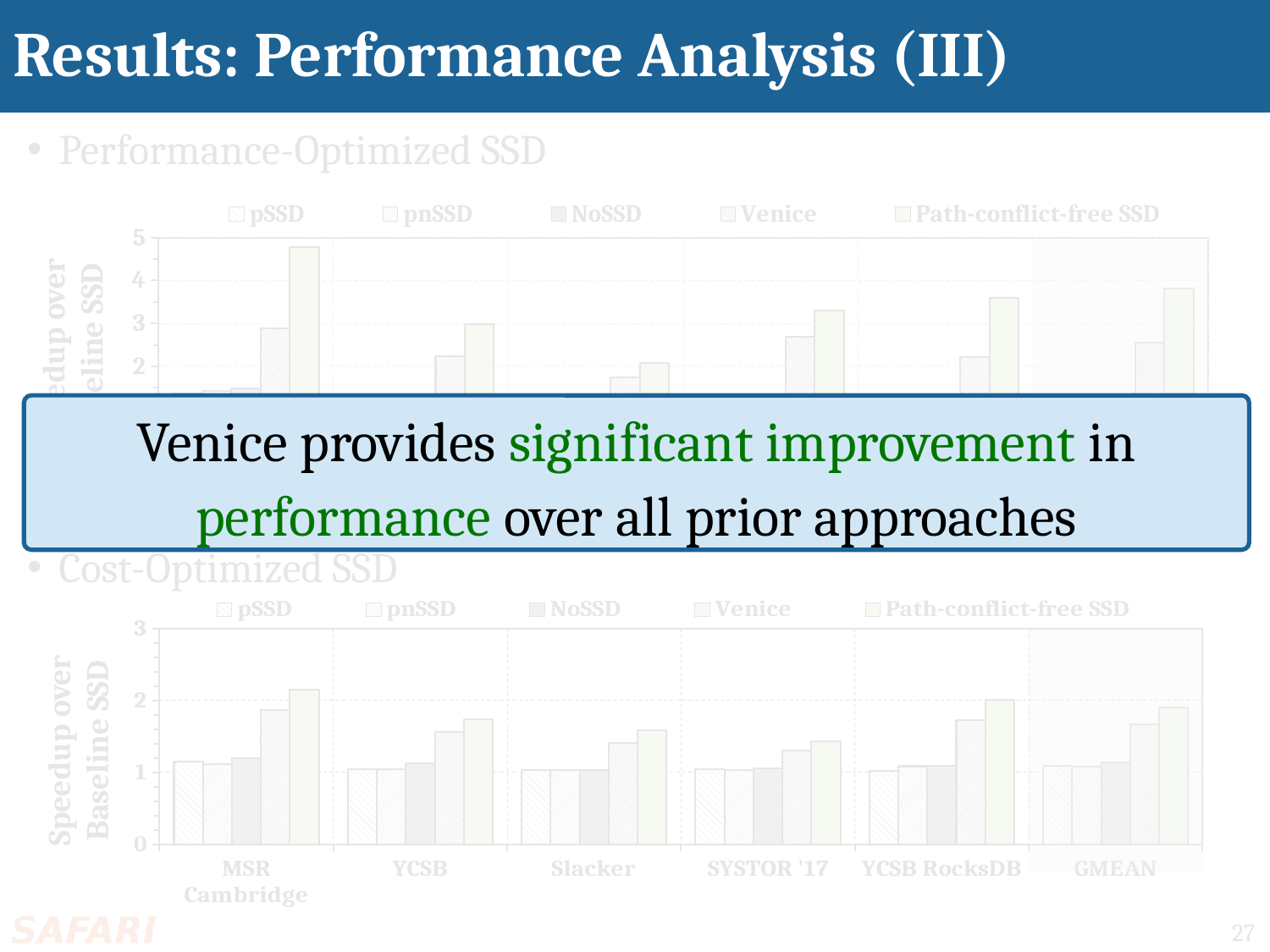
In the Cost-Optimized SSD chart, which series has the highest bar for MSR Cambridge? Path-conflict-free SSD In the Performance-Optimized SSD chart at the top, is the Path-conflict-free SSD value for MSR Cambridge greater or less than 4? greater In the Cost-Optimized SSD chart, is the Path-conflict-free SSD value for MSR Cambridge greater or less than 2? greater In the Cost-Optimized SSD chart, which is larger for MSR Cambridge: the Venice bar or the NoSSD bar? Venice How many workload categories are shown on the x axis of the Cost-Optimized SSD chart? 6 What kind of chart is the Cost-Optimized SSD chart at the bottom of the slide? bar chart In the Performance-Optimized SSD chart at the top, is the Venice value for SYSTOR '17 greater or less than 2? greater How many series does the legend of the Cost-Optimized SSD chart list? 5 What is the y-axis label of the Cost-Optimized SSD chart? Speedup over Baseline SSD